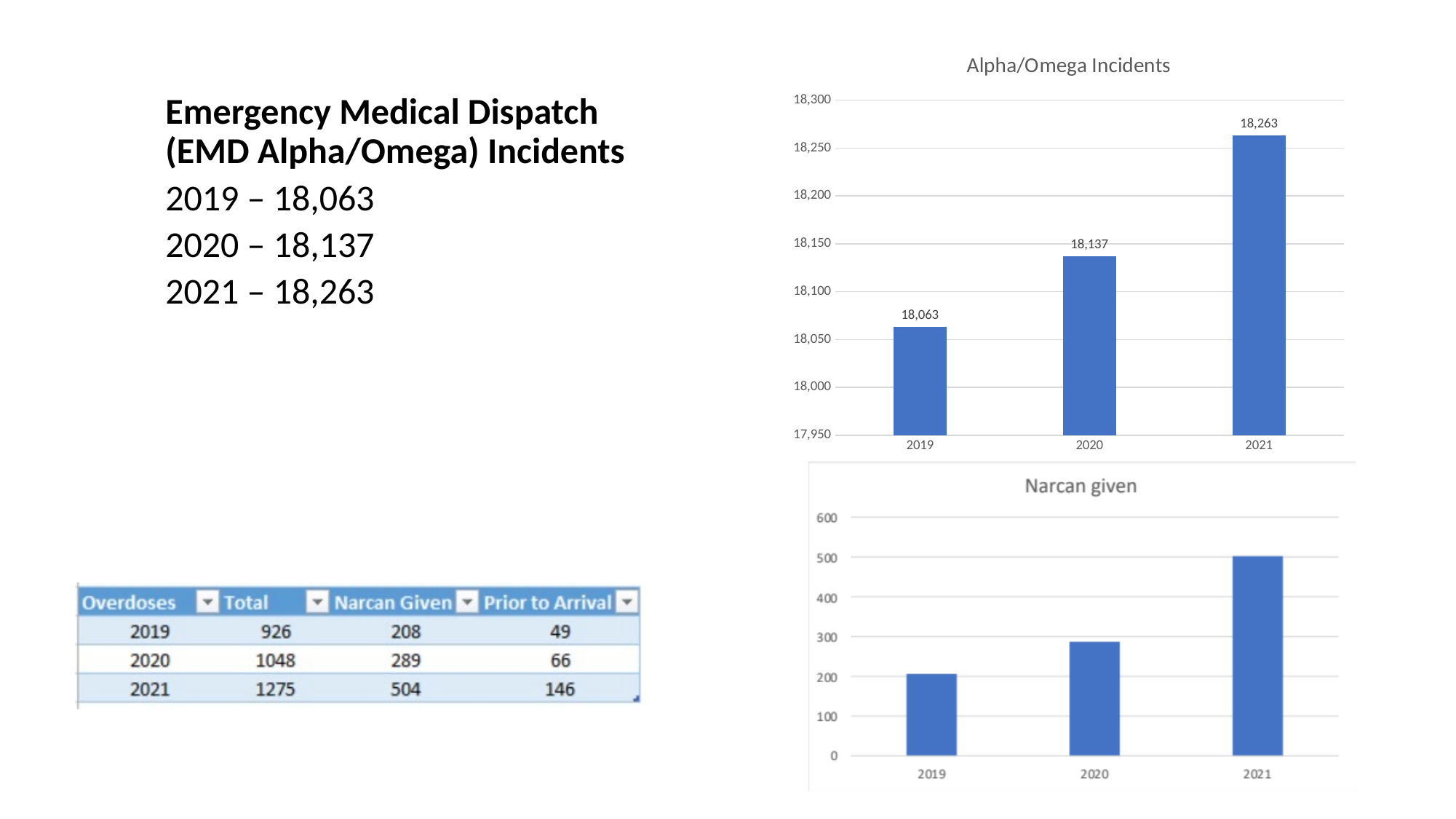
In the Alpha/Omega Incidents chart, which year has the lowest value? 2019 What kind of chart is the Narcan given chart? bar chart In the Alpha/Omega Incidents chart, what is the value for 2021? 18,263 How many bars are in the Alpha/Omega Incidents chart? 3 In the Alpha/Omega Incidents chart, what is the value for 2019? 18,063 In the Alpha/Omega Incidents chart, which year has the highest value? 2021 In the Alpha/Omega Incidents chart, do the values rise or fall from 2019 to 2021? rise What is the title of the upper chart on the right side of the slide? Alpha/Omega Incidents In the Alpha/Omega Incidents chart, what is the difference between the 2021 and 2020 values? 126 In the Narcan given chart, is the value for 2019 greater or less than 300? less In the Narcan given chart, is the value for 2021 greater or less than 400? greater In the Narcan given chart, which year has the highest value? 2021